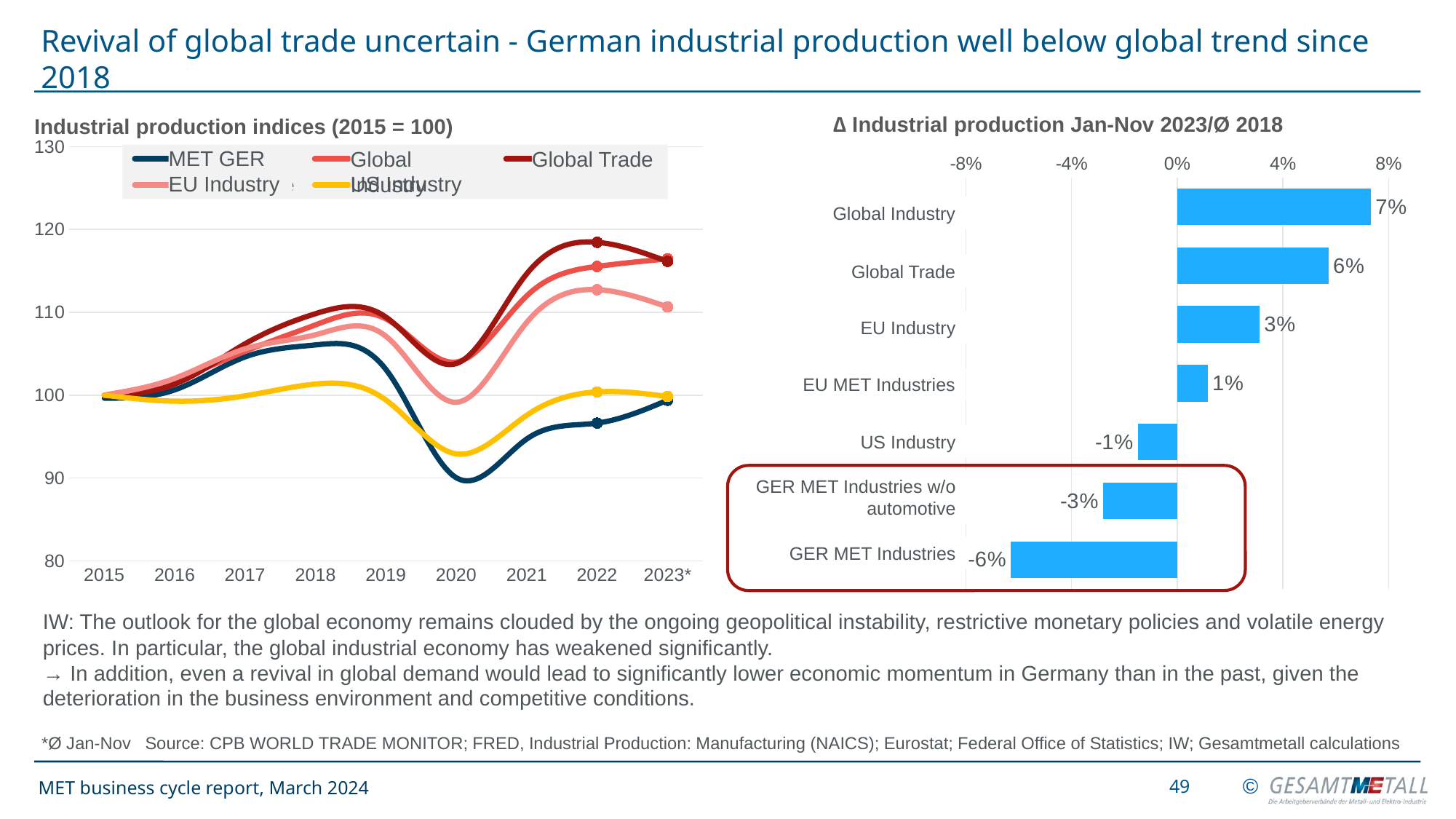
In the chart titled 'Industrial production indices (2015 = 100)', is the value for Global Trade in 2022 greater or less than 110? greater How many categories are shown in the chart titled 'Δ Industrial production Jan-Nov 2023/Ø 2018'? 7 In the chart titled 'Δ Industrial production Jan-Nov 2023/Ø 2018', which category has the lowest value? GER MET Industries In the chart titled 'Δ Industrial production Jan-Nov 2023/Ø 2018', what is the value for GER MET Industries w/o automotive? -3% What kind of chart is the chart titled 'Industrial production indices (2015 = 100)'? Line chart In the chart titled 'Industrial production indices (2015 = 100)', is the value for MET GER in 2020 greater or less than 100? less In the chart titled 'Δ Industrial production Jan-Nov 2023/Ø 2018', what is the value for GER MET Industries? -6% In the chart titled 'Δ Industrial production Jan-Nov 2023/Ø 2018', which is larger: the value for Global Trade or the value for EU MET Industries? Global Trade In the chart titled 'Δ Industrial production Jan-Nov 2023/Ø 2018', what is the value for Global Industry? 7% In the chart titled 'Δ Industrial production Jan-Nov 2023/Ø 2018', what is the difference between the values for Global Industry and EU Industry? 4 percentage points What kind of chart is the chart titled 'Δ Industrial production Jan-Nov 2023/Ø 2018'? Bar chart In the chart titled 'Δ Industrial production Jan-Nov 2023/Ø 2018', which category has the highest value? Global Industry